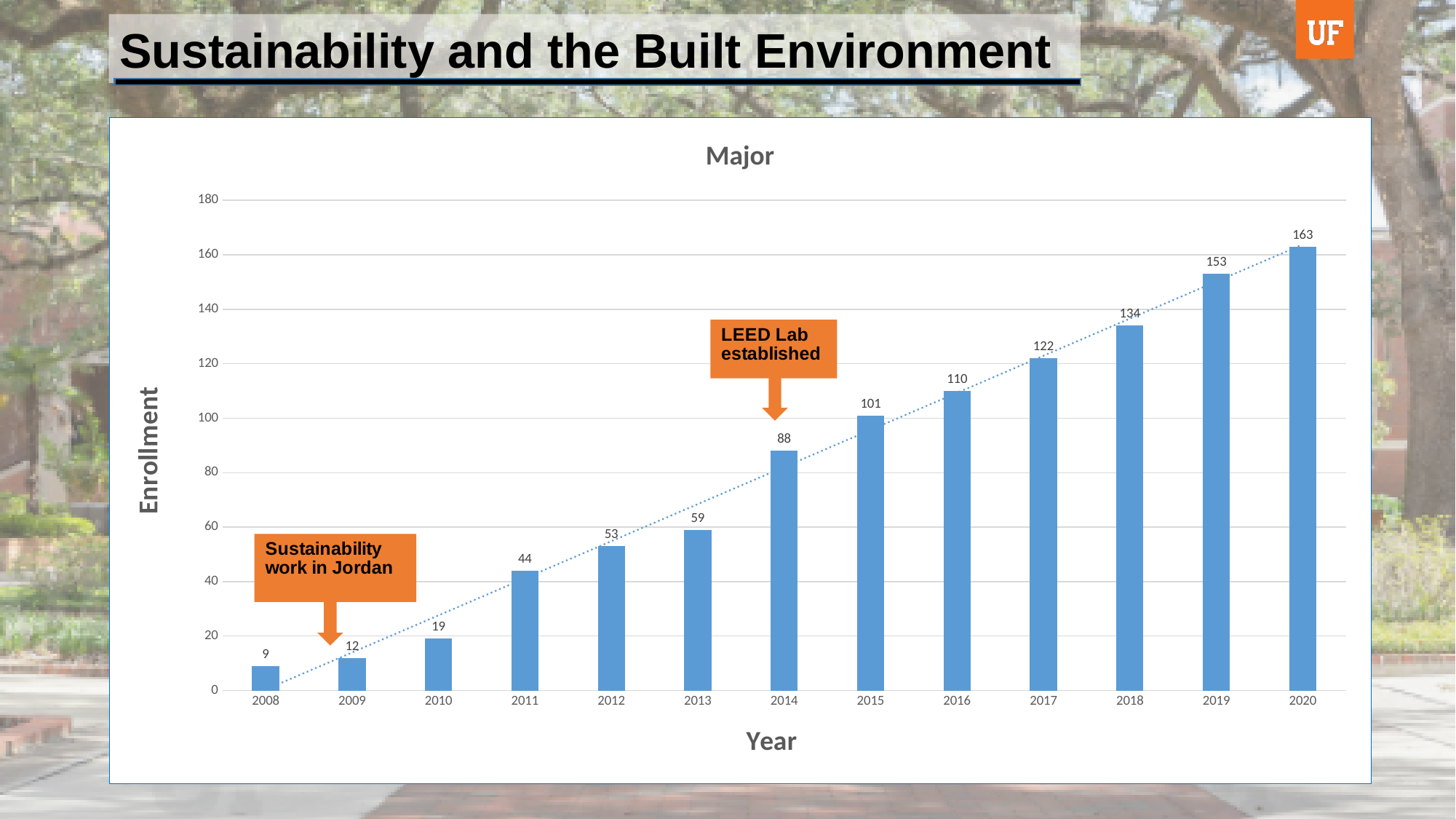
What is the enrollment value for 2011? 44 Which year has the highest enrollment? 2020 What is the difference in enrollment between 2020 and 2019? 10 Is the enrollment value for 2018 greater or less than 120? greater What is the enrollment value for 2014? 88 What kind of chart is shown on the slide? Bar chart How many years are shown on the x axis? 13 Do the enrollment values rise or fall from 2008 to 2020? Rise Which year has the lowest enrollment? 2008 What is the title of the chart? Major Which year has a larger enrollment, 2013 or 2016? 2016 What is the difference in enrollment between 2017 and 2012? 69